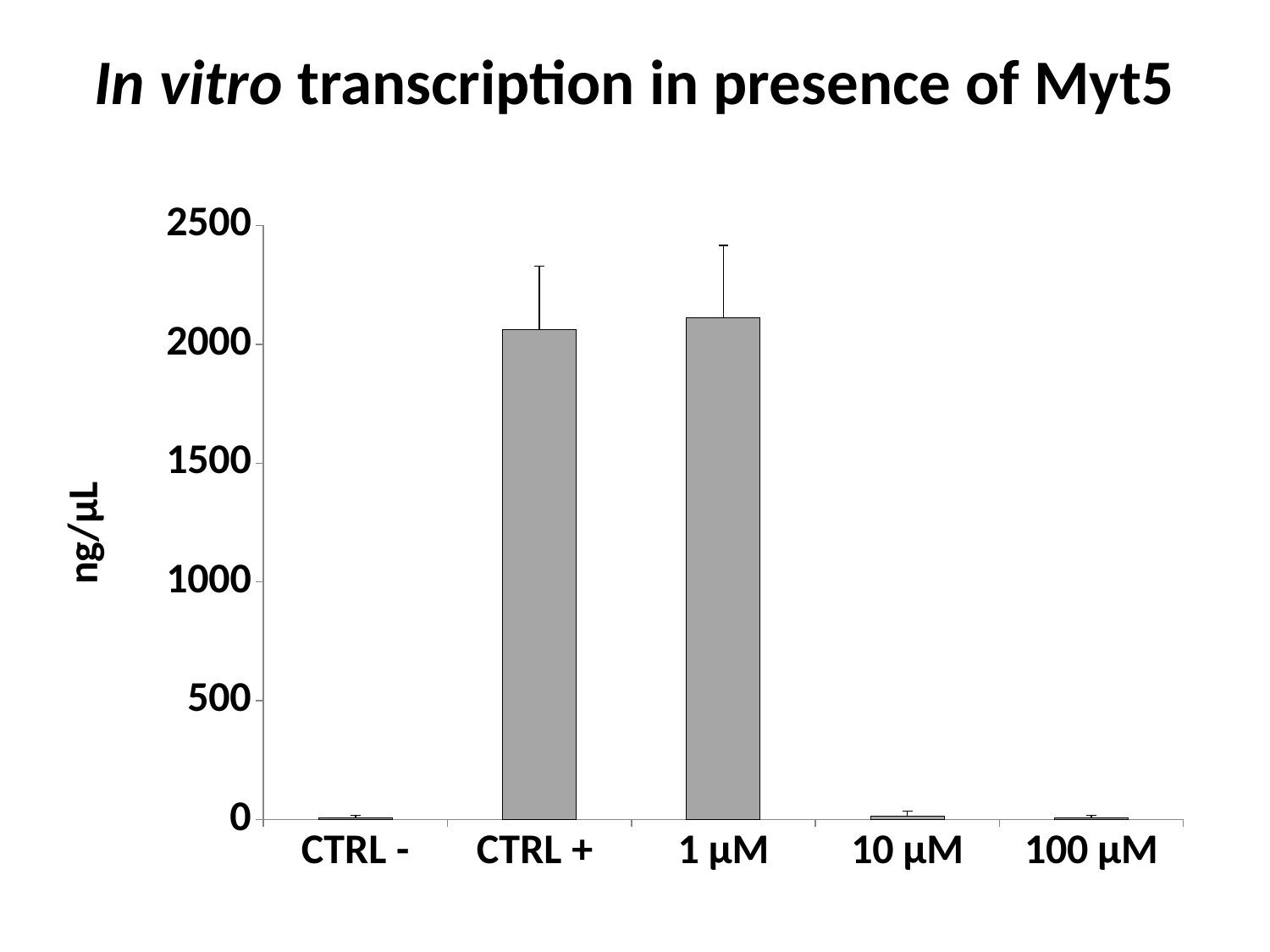
Is the value for 10 µM greater or less than 500? less Is the value for CTRL + greater or less than 2000? greater Is the value for 1 µM greater or less than 2000? greater What kind of chart is shown on the slide? bar chart What is the label of the y axis of the chart? ng/µL How many categories are shown on the x axis of the chart? 5 What is the title of the slide? In vitro transcription in presence of Myt5 Which is larger, the value for 1 µM or the value for 100 µM? 1 µM Which is larger, the value for CTRL + or the value for 10 µM? CTRL + Which is larger, the value for CTRL - or the value for CTRL +? CTRL +